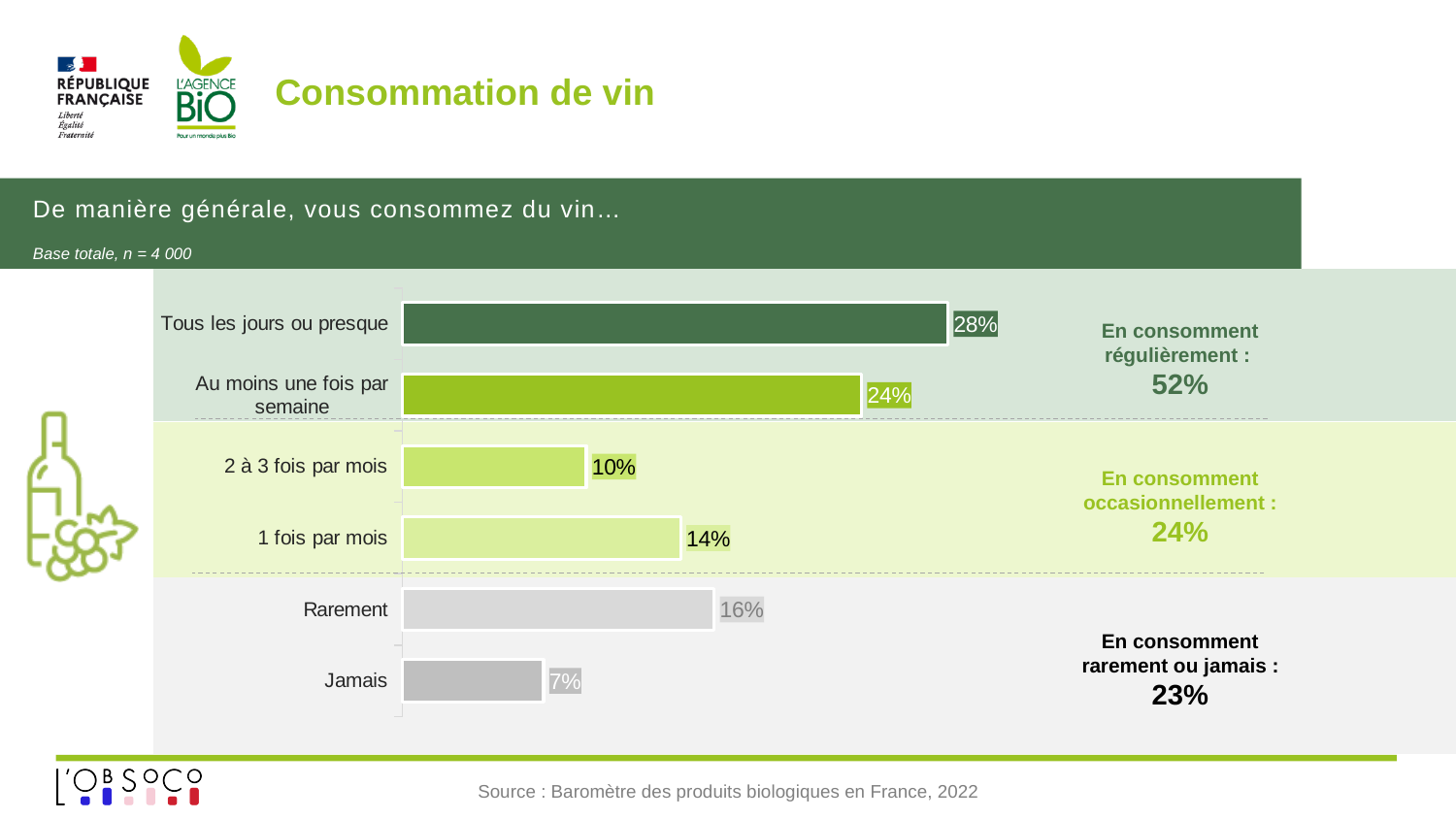
How many categories are shown in the chart? 6 What is the value for 'Jamais'? 7% What is the value for 'Au moins une fois par semaine'? 24% Which category has the lowest value? Jamais What is the value for 'Rarement'? 16% What kind of chart is shown on the slide? Bar chart What percentage of respondents consume wine 'Tous les jours ou presque'? 28% What is the combined share of respondents who consume wine regularly ('En consomment régulièrement')? 52% Which category has the highest value? Tous les jours ou presque What is the difference between 'Tous les jours ou presque' and 'Au moins une fois par semaine'? 4% What is the base size (n) stated for the chart? n = 4 000 Which is larger: '1 fois par mois' or '2 à 3 fois par mois'? 1 fois par mois